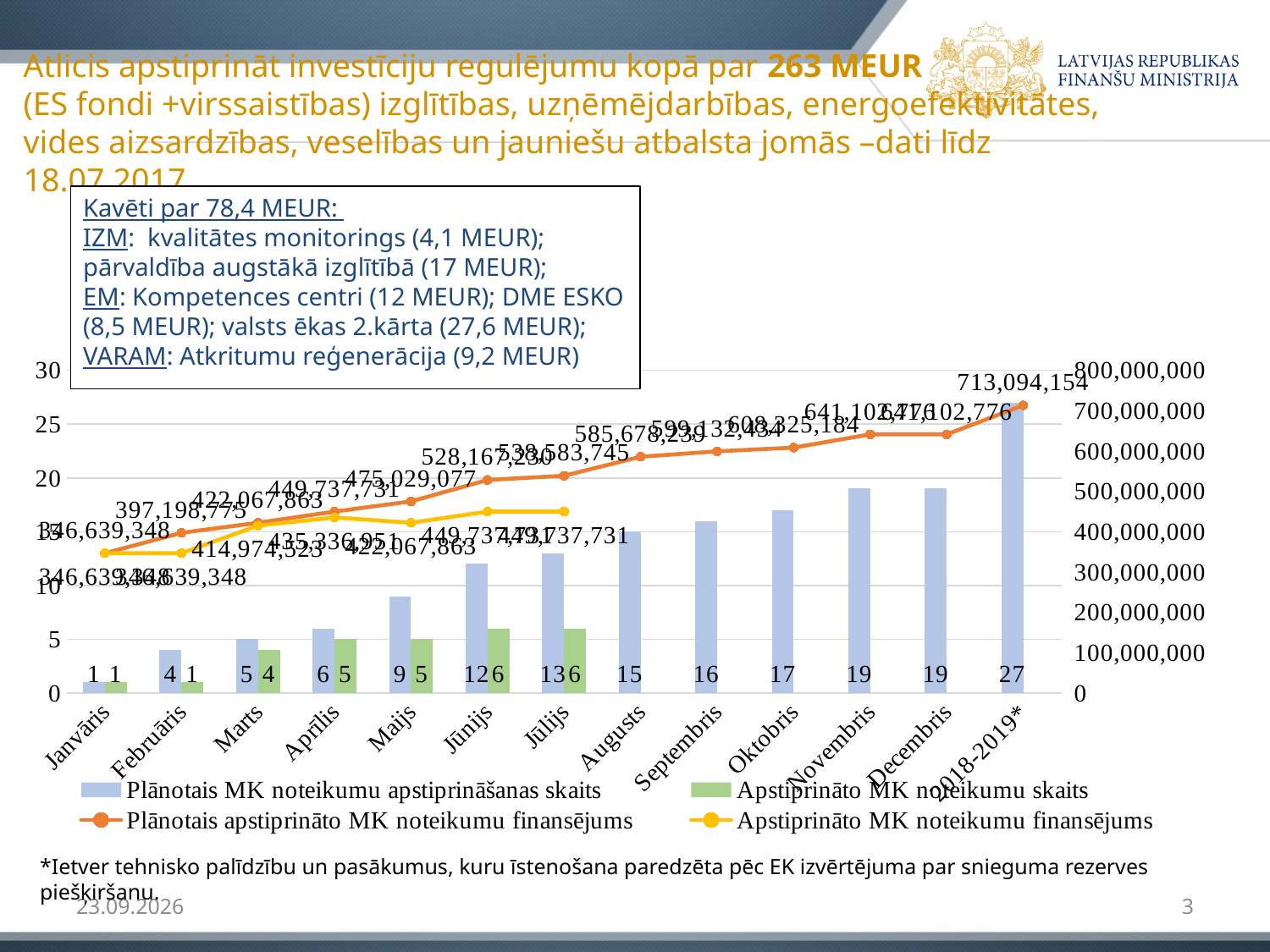
How many series does the chart legend list? 4 Is the value of 'Plānotais apstiprināto MK noteikumu finansējums' for Janvāris greater or less than 400,000,000? less What is the difference between the planned count (13) and the approved count (6) for Jūlijs? 7 What is the value of 'Plānotais MK noteikumu apstiprināšanas skaits' for 2018-2019*? 27 What is the value of 'Plānotais apstiprināto MK noteikumu finansējums' for 2018-2019*? 713,094,154 What kind of chart is shown on the slide? A combined bar and line chart Does 'Plānotais MK noteikumu apstiprināšanas skaits' generally rise or fall from Janvāris to 2018-2019*? Rise What is the value of 'Plānotais MK noteikumu apstiprināšanas skaits' for Oktobris? 17 What is the value of 'Apstiprināto MK noteikumu skaits' for Jūlijs? 6 How many categories are shown along the x axis of the chart? 13 Which category has the highest value for 'Plānotais MK noteikumu apstiprināšanas skaits'? 2018-2019* For Maijs, which is larger: 'Plānotais MK noteikumu apstiprināšanas skaits' or 'Apstiprināto MK noteikumu skaits'? Plānotais MK noteikumu apstiprināšanas skaits